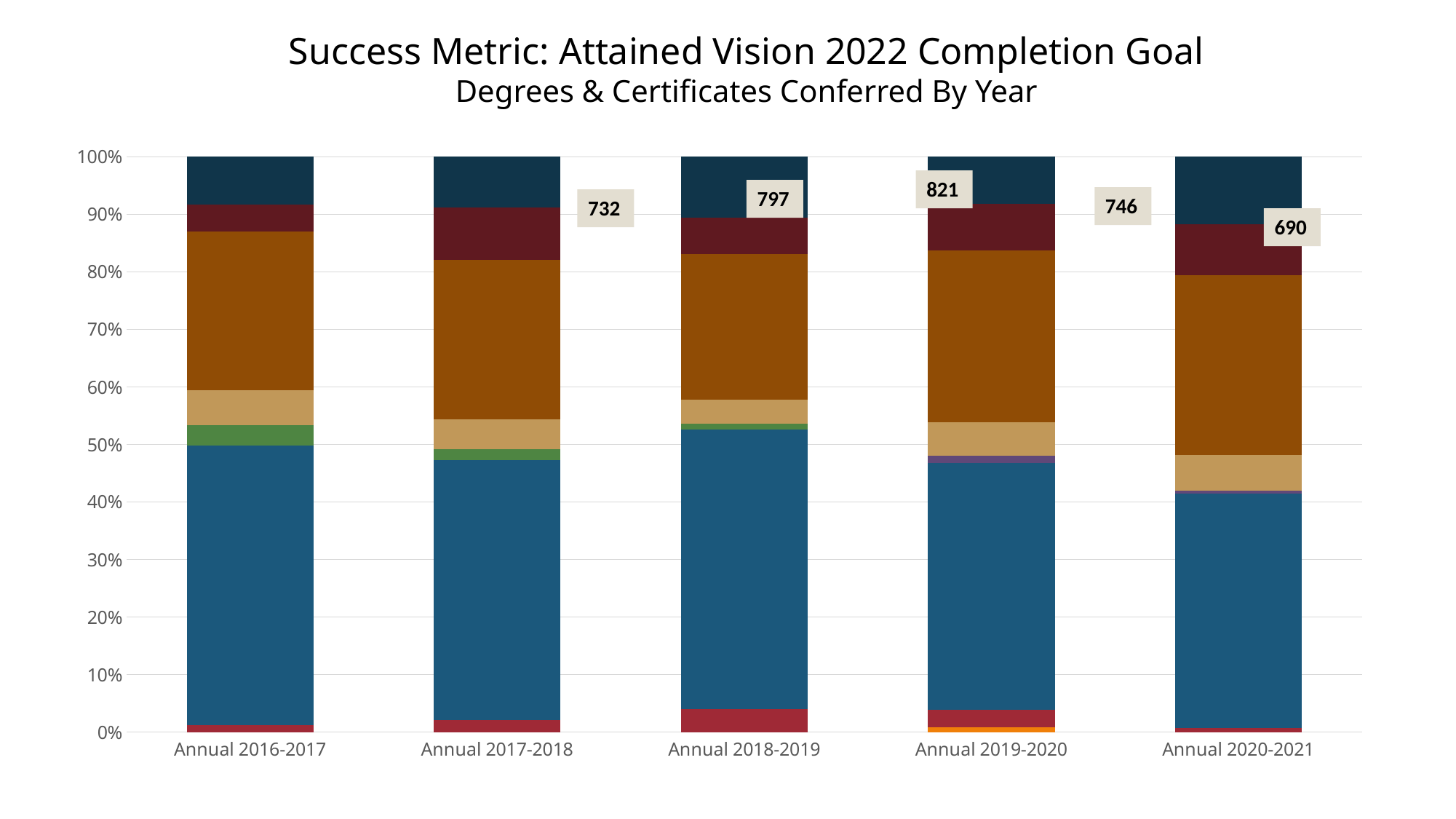
Which year has the smallest bottom blue segment? Annual 2020-2021 What kind of chart is shown on the slide? Stacked bar chart What is the subtitle of the chart? Degrees & Certificates Conferred By Year Is the top of the bottom blue segment for Annual 2018-2019 greater or less than 50%? greater What is the highest value shown on the y axis? 100% Which year has the larger dark red segment near the top of the bar, Annual 2016-2017 or Annual 2020-2021? Annual 2020-2021 Is the top of the bottom blue segment for Annual 2020-2021 greater or less than 50%? less Is the top of the bottom blue segment for Annual 2020-2021 greater or less than 40%? greater How many year categories are shown on the x axis? 5 What is the main title of the chart? Success Metric: Attained Vision 2022 Completion Goal Which year has the larger top dark navy segment, Annual 2016-2017 or Annual 2020-2021? Annual 2020-2021 Which year has the larger bottom blue segment, Annual 2018-2019 or Annual 2020-2021? Annual 2018-2019